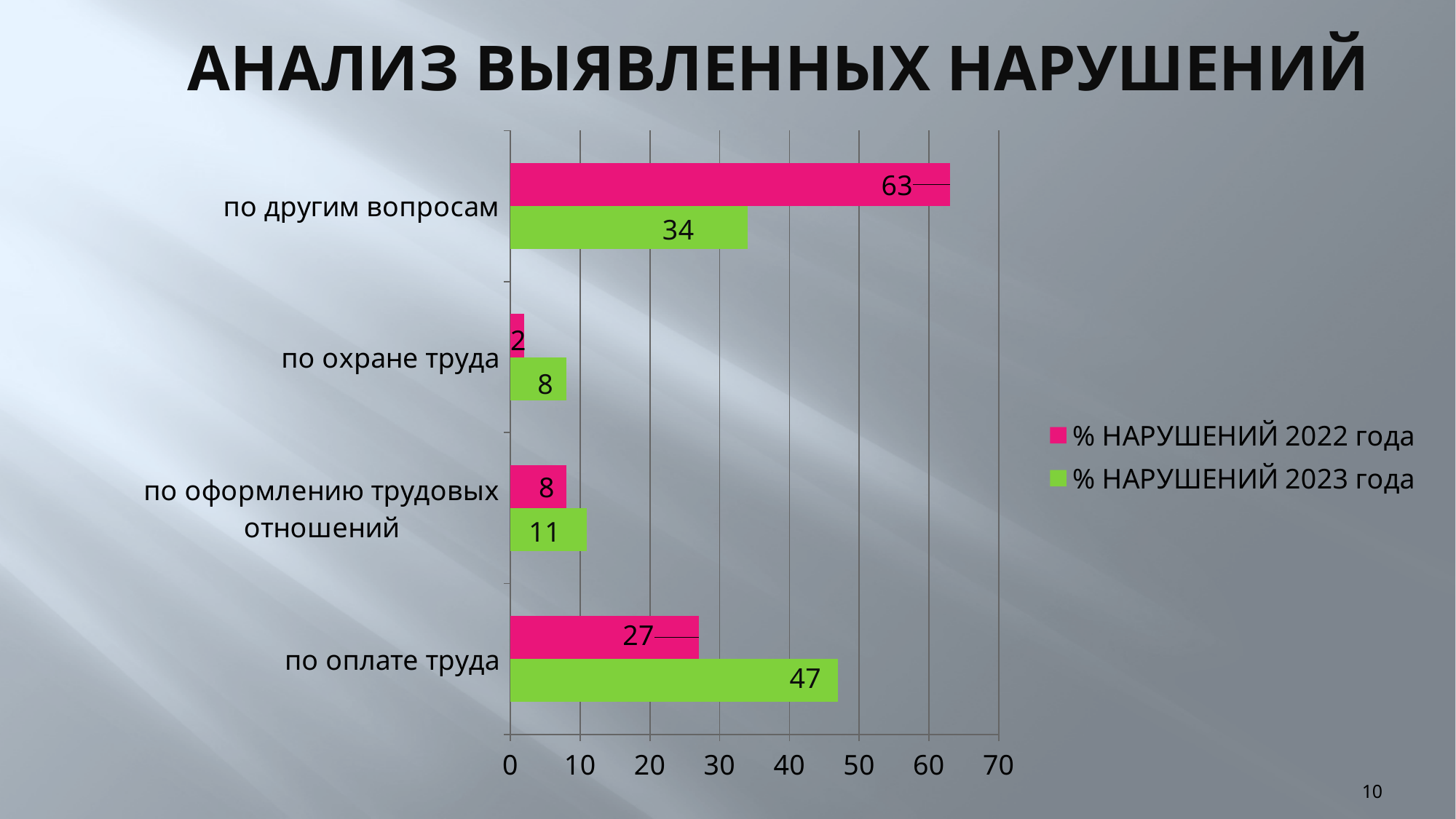
What is the value for "по оформлению трудовых отношений" in the "% НАРУШЕНИЙ 2022 года" series? 8 How many series does the legend list? 2 What is the value for "по оплате труда" in the "% НАРУШЕНИЙ 2023 года" series? 47 Which category has the lowest value in the "% НАРУШЕНИЙ 2022 года" series? по охране труда What is the value for "по охране труда" in the "% НАРУШЕНИЙ 2023 года" series? 8 What is the difference between the 2022 and 2023 values for "по другим вопросам"? 29 What is the value for "по другим вопросам" in the "% НАРУШЕНИЙ 2022 года" series? 63 What kind of chart is shown on the slide? bar chart For "по оплате труда", which series has the larger value: "% НАРУШЕНИЙ 2022 года" or "% НАРУШЕНИЙ 2023 года"? % НАРУШЕНИЙ 2023 года Which category has the highest value in the "% НАРУШЕНИЙ 2022 года" series? по другим вопросам Which category has the highest value in the "% НАРУШЕНИЙ 2023 года" series? по оплате труда How many categories are shown on the chart? 4